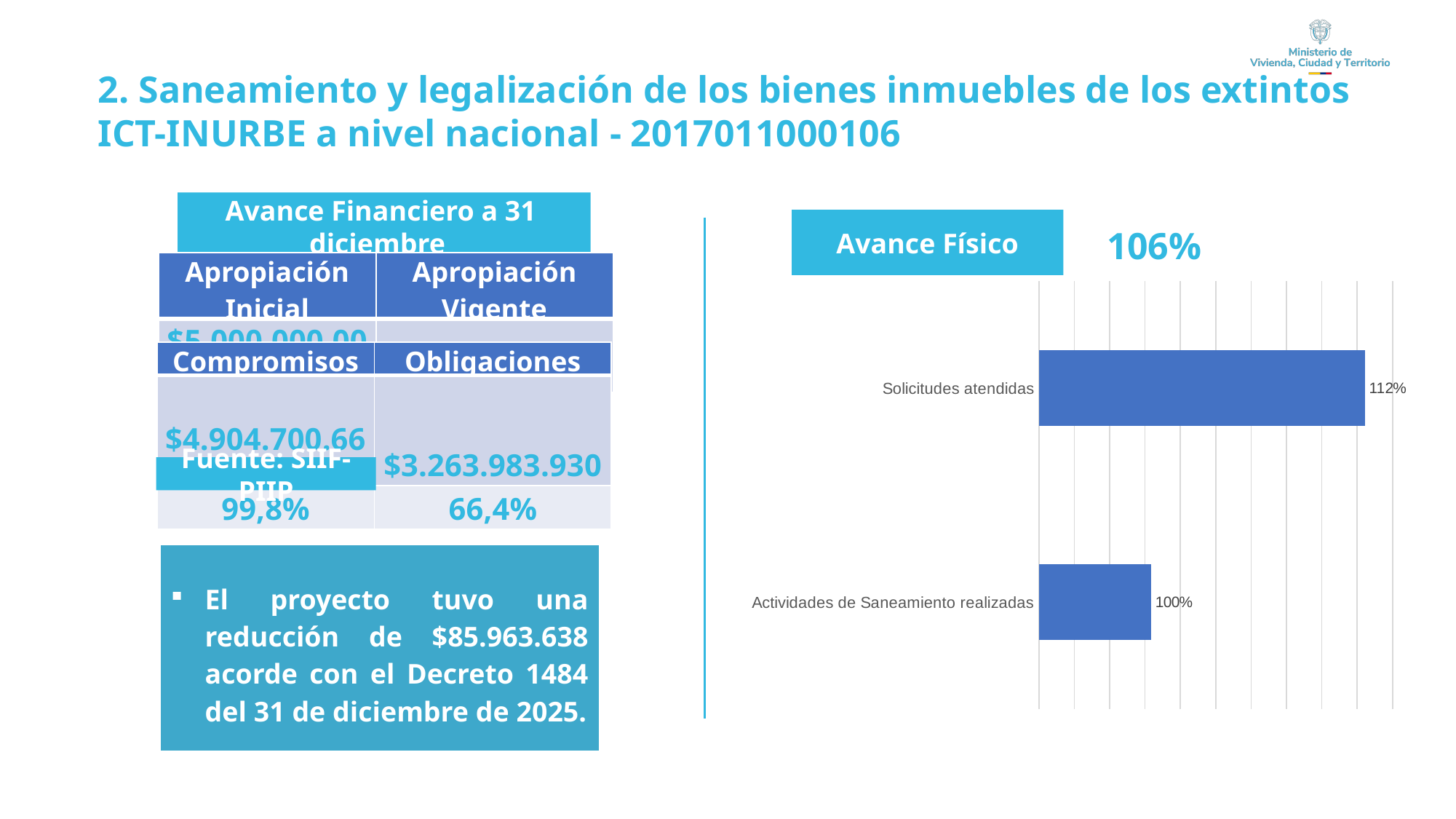
What type of chart is shown under "Avance Físico"? bar chart How many categories are plotted in the Avance Físico chart? 2 In the Avance Físico chart, which is larger: "Solicitudes atendidas" or "Actividades de Saneamiento realizadas"? Solicitudes atendidas What overall percentage is displayed next to the "Avance Físico" title? 106% What is the value for "Solicitudes atendidas" in the Avance Físico chart? 112% What is the title shown above the bar chart on the right of the slide? Avance Físico Which category has the lowest value in the Avance Físico chart? Actividades de Saneamiento realizadas What is the value for "Actividades de Saneamiento realizadas" in the Avance Físico chart? 100% Which category has the highest value in the Avance Físico chart? Solicitudes atendidas What is the difference between the values for "Solicitudes atendidas" and "Actividades de Saneamiento realizadas" in the Avance Físico chart? 12%